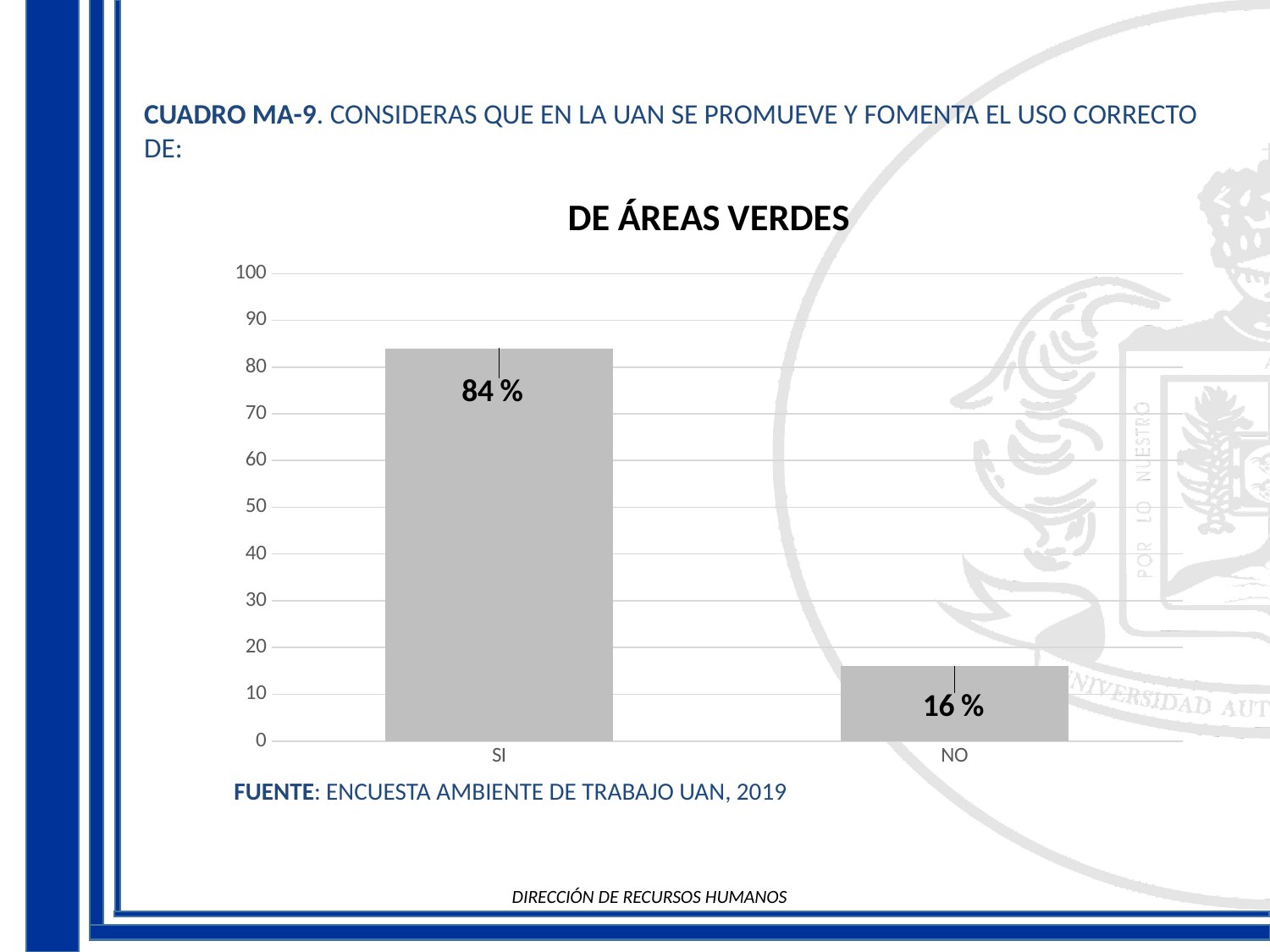
Which category has the lowest value? NO What is the value for SI? 84 % What kind of chart is shown? bar chart What is the maximum value shown on the y axis? 100 What is the difference between the values for SI and NO? 68 % Is the value for SI greater or less than 80? greater Which category has the highest value? SI Which is larger, the value for SI or the value for NO? SI Is the value for NO greater or less than 20? less What is the value for NO? 16 % How many categories are shown on the x axis? 2 What is the title of the chart? DE ÁREAS VERDES